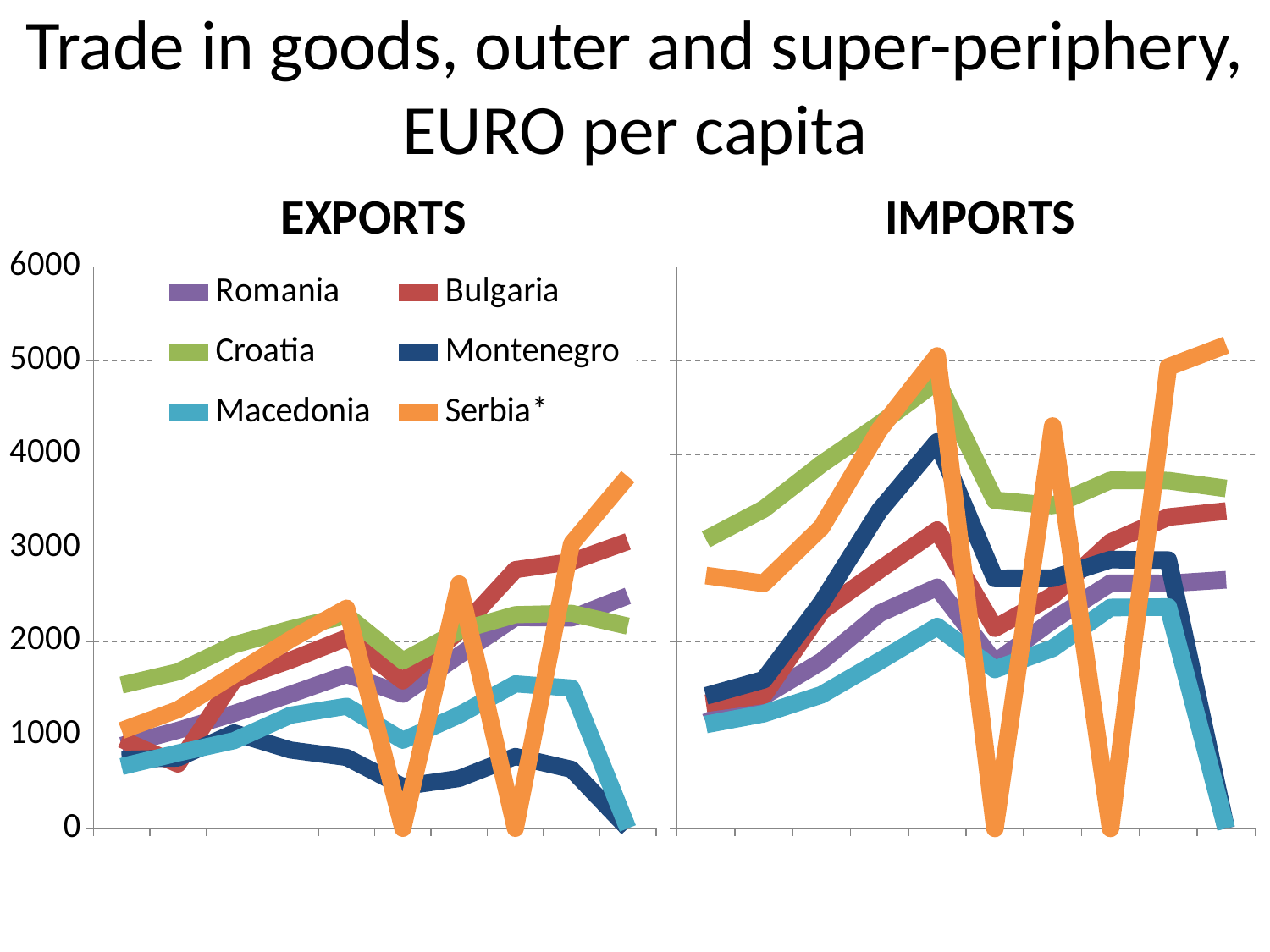
On the IMPORTS chart, which series reaches the highest value? Serbia* What colour is the Serbia* line in the legend? orange On the IMPORTS chart, does the Bulgaria line overall rise or fall from left to right? rise On the IMPORTS chart, which series reaches a higher peak: Croatia or Montenegro? Croatia On the EXPORTS chart, which series reaches the highest value? Serbia* What kind of chart is the EXPORTS chart? line chart On the EXPORTS chart, is the final value for Serbia* greater or less than 3000? greater On the EXPORTS chart, at the final point, which is higher: Serbia* or Bulgaria? Serbia* On the IMPORTS chart, is the final value for Bulgaria greater or less than 3000? greater On the EXPORTS chart, is the first value for Croatia greater or less than 2000? less How many series does the legend on the EXPORTS chart list? 6